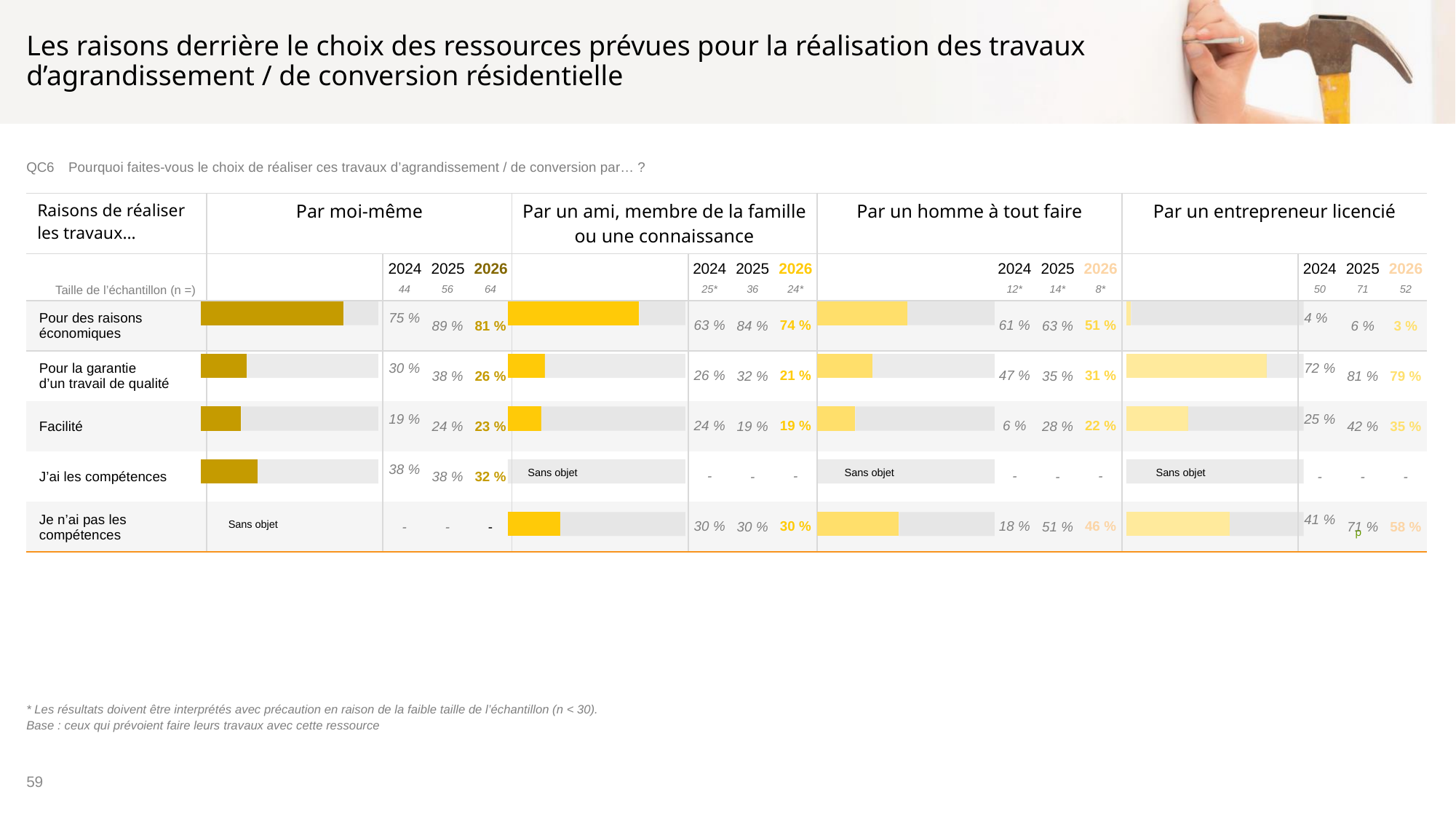
For 'Pour des raisons économiques' in 2026, which is larger: the 'Par un ami, membre de la famille ou une connaissance' value or the 'Par un homme à tout faire' value? Par un ami, membre de la famille ou une connaissance In the 'Par un homme à tout faire' chart, what is the 2025 value for 'Je n'ai pas les compétences'? 51 % How many reasons (row categories) are listed in the table? 5 In the 'Par un homme à tout faire' chart, did the value for 'Facilité' rise or fall from 2024 to 2025? rise In the 'Par un entrepreneur licencié' chart, what is the 2025 value for 'Pour la garantie d'un travail de qualité'? 81 % What is the 2026 sample size (n) shown for 'Par moi-même'? 64 In the 'Par un homme à tout faire' chart, which reason has the highest 2026 value? Pour des raisons économiques What kind of chart is used to display the values in each column of the table? bar chart In the 'Par un entrepreneur licencié' chart, which reason has the lowest 2026 value? Pour des raisons économiques In the 'Par moi-même' chart, what is the 2026 value for 'Pour des raisons économiques'? 81 % In the 'Par moi-même' chart, what is the difference between the 2025 and 2026 values for 'Pour des raisons économiques'? 8 points In the 'Par un entrepreneur licencié' chart, what is the difference between the 2026 values for 'Pour la garantie d'un travail de qualité' and 'Facilité'? 44 points